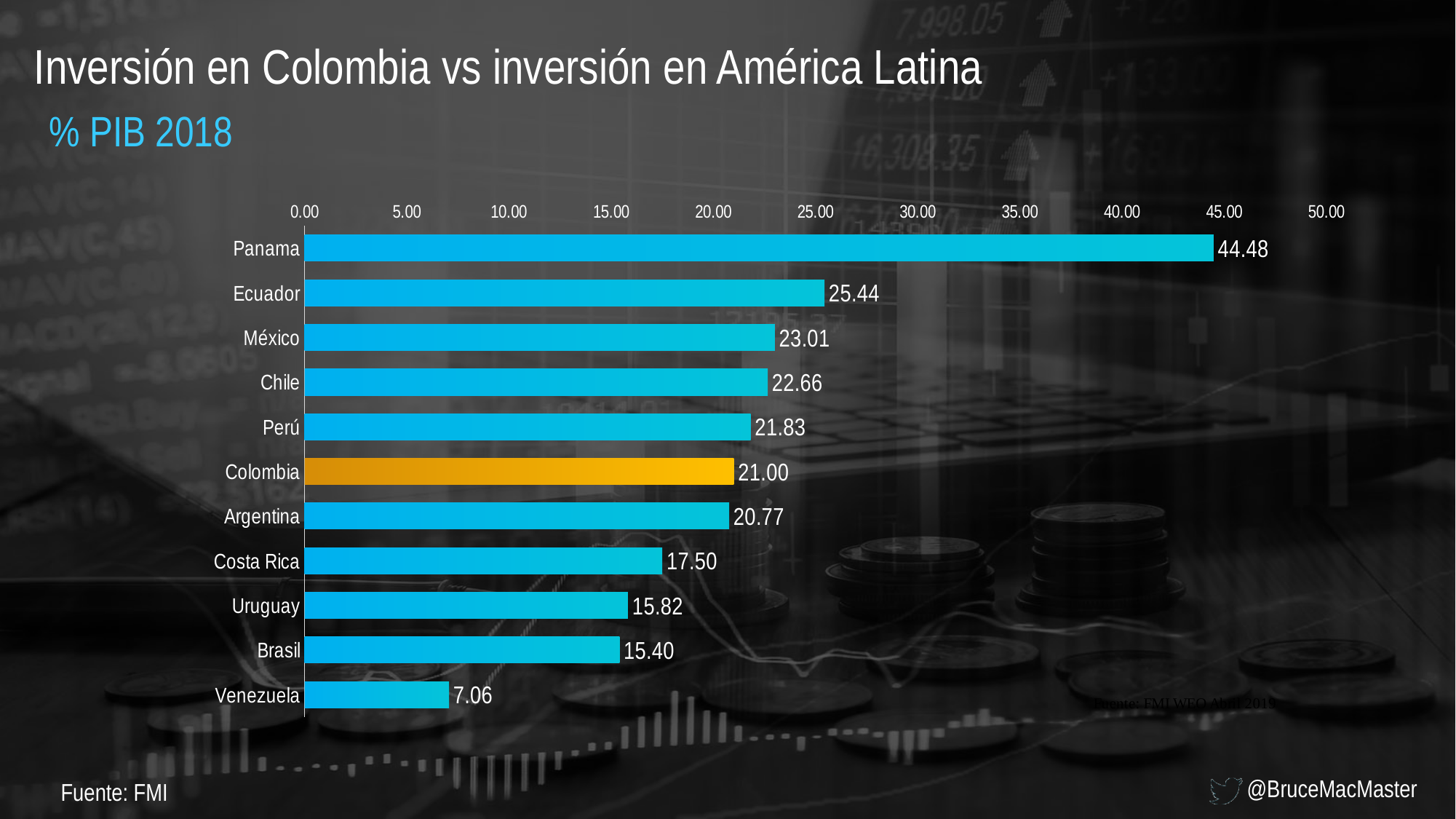
Which is larger, the value for Costa Rica or the value for Uruguay? Costa Rica How many countries are shown in the chart? 11 What kind of chart is shown on the slide? bar chart What is the value for Panama? 44.48 What is the difference between the values for Panama and Ecuador? 19.04 What is the value for Venezuela? 7.06 Which country's bar is highlighted in a different colour (orange/yellow) from the others? Colombia Which country has the lowest value? Venezuela What is the value for Colombia? 21.00 What is the difference between the values for Colombia and Argentina? 0.23 Which country has the highest value? Panama Is the value for Brasil greater or less than 20.00? less